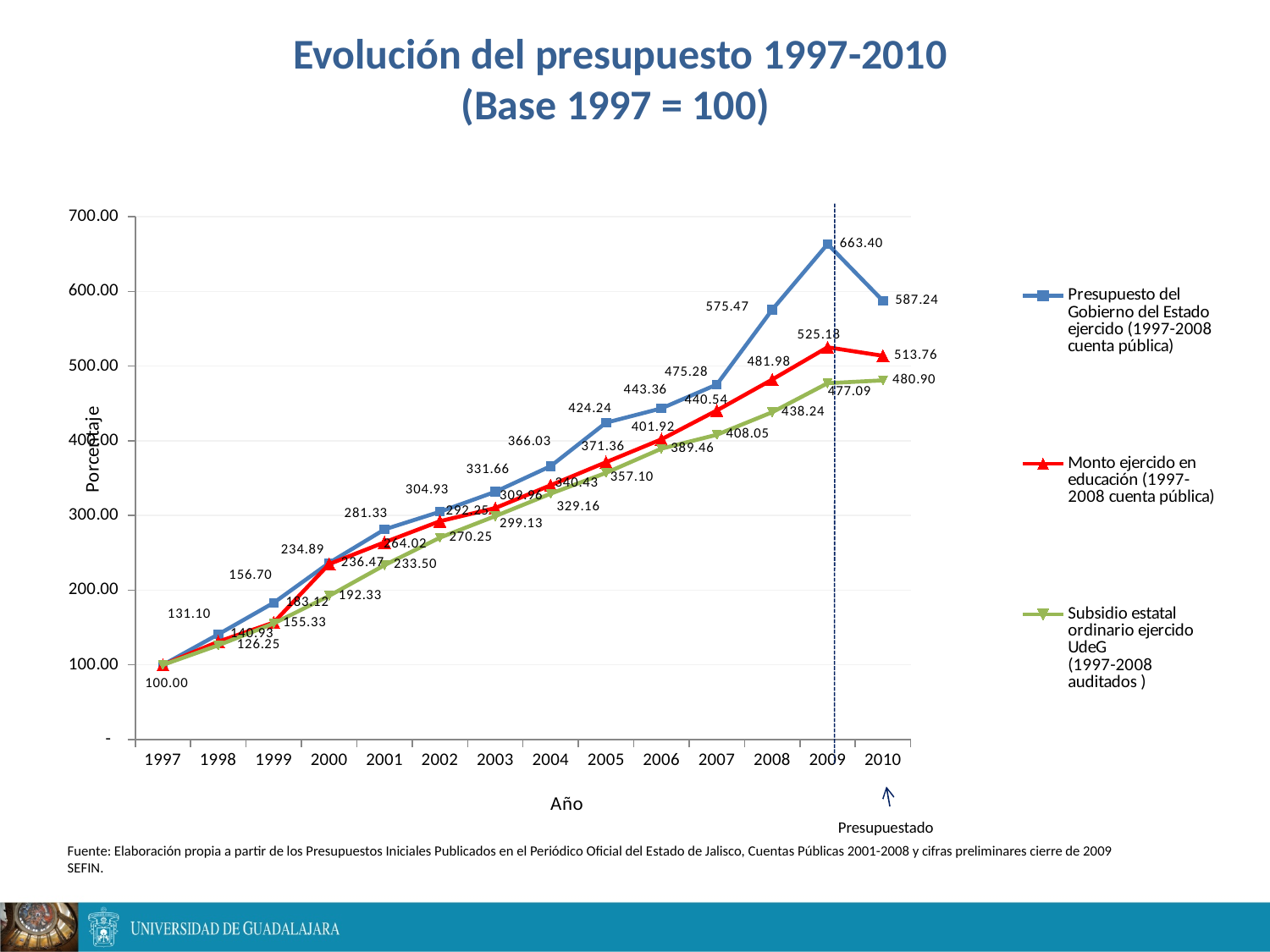
What is the value of Monto ejercido en educación in 2009? 525.18 By how much did Presupuesto del Gobierno del Estado ejercido fall from 2009 to 2010? 76.16 In 2010, which is larger: Presupuesto del Gobierno del Estado ejercido or Subsidio estatal ordinario ejercido UdeG? Presupuesto del Gobierno del Estado ejercido What is the title of the x axis? Año What is the value of Presupuesto del Gobierno del Estado ejercido in 2009? 663.40 In which year does Presupuesto del Gobierno del Estado ejercido reach its highest value? 2009 What kind of chart is shown on the slide? line chart How many series does the legend list? 3 What is the value of Presupuesto del Gobierno del Estado ejercido in 2010? 587.24 What is the value of Subsidio estatal ordinario ejercido UdeG in 2010? 480.90 How many years are plotted along the x axis? 14 Does Presupuesto del Gobierno del Estado ejercido rise or fall from 1997 to 2009? rise